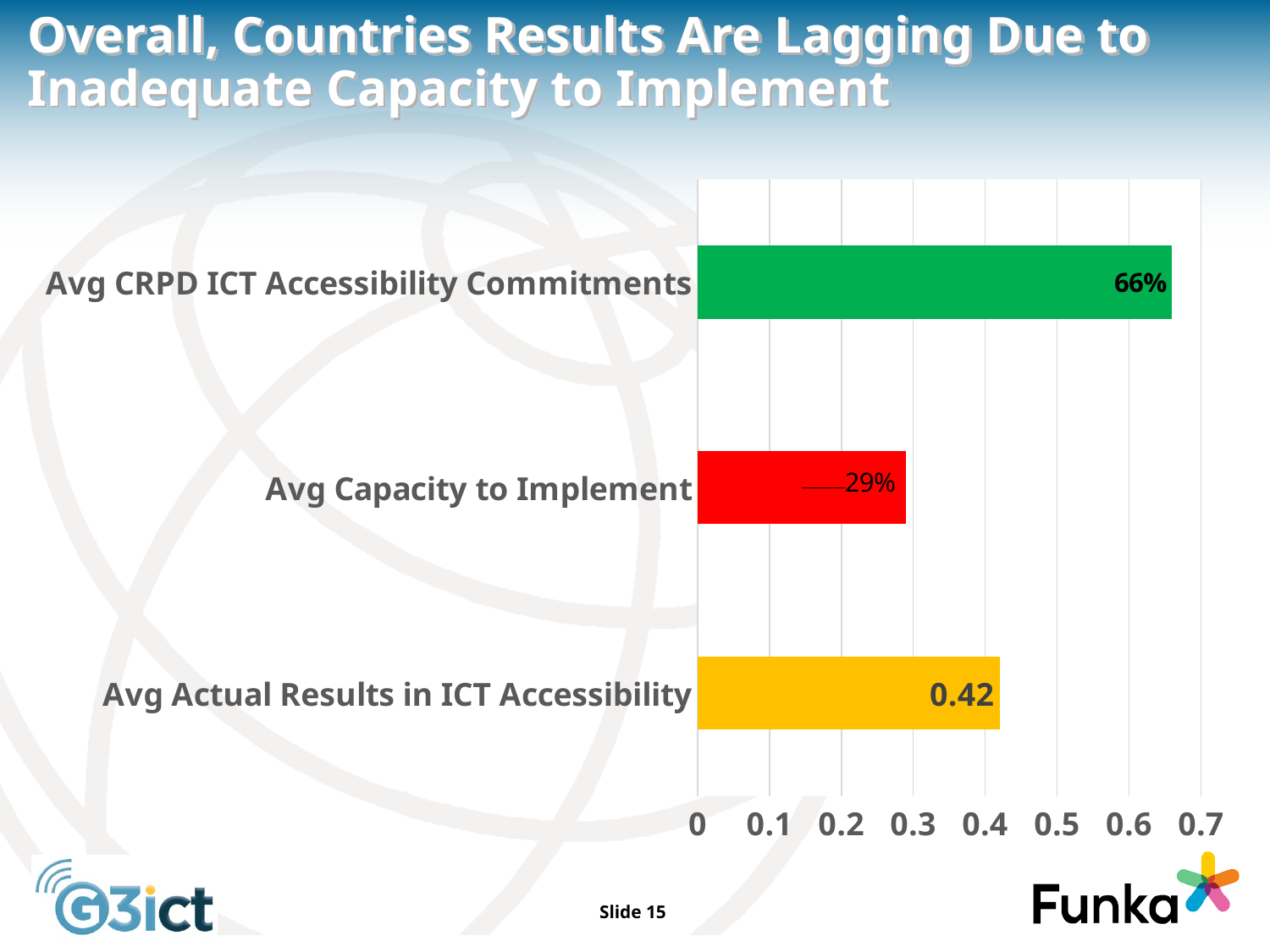
Is the value for Avg Capacity to Implement greater or less than 0.3? less What colour is the bar for Avg Capacity to Implement? Red What is the value for Avg Capacity to Implement? 29% Which is larger, Avg Actual Results in ICT Accessibility or Avg Capacity to Implement? Avg Actual Results in ICT Accessibility Which is larger, Avg CRPD ICT Accessibility Commitments or Avg Actual Results in ICT Accessibility? Avg CRPD ICT Accessibility Commitments How many categories are shown in the chart? 3 What is the value for Avg Actual Results in ICT Accessibility? 0.42 Is the value for Avg CRPD ICT Accessibility Commitments greater or less than 0.6? greater What is the value for Avg CRPD ICT Accessibility Commitments? 66% Which category has the lowest value? Avg Capacity to Implement What kind of chart is shown on the slide? Bar chart Which category has the highest value? Avg CRPD ICT Accessibility Commitments